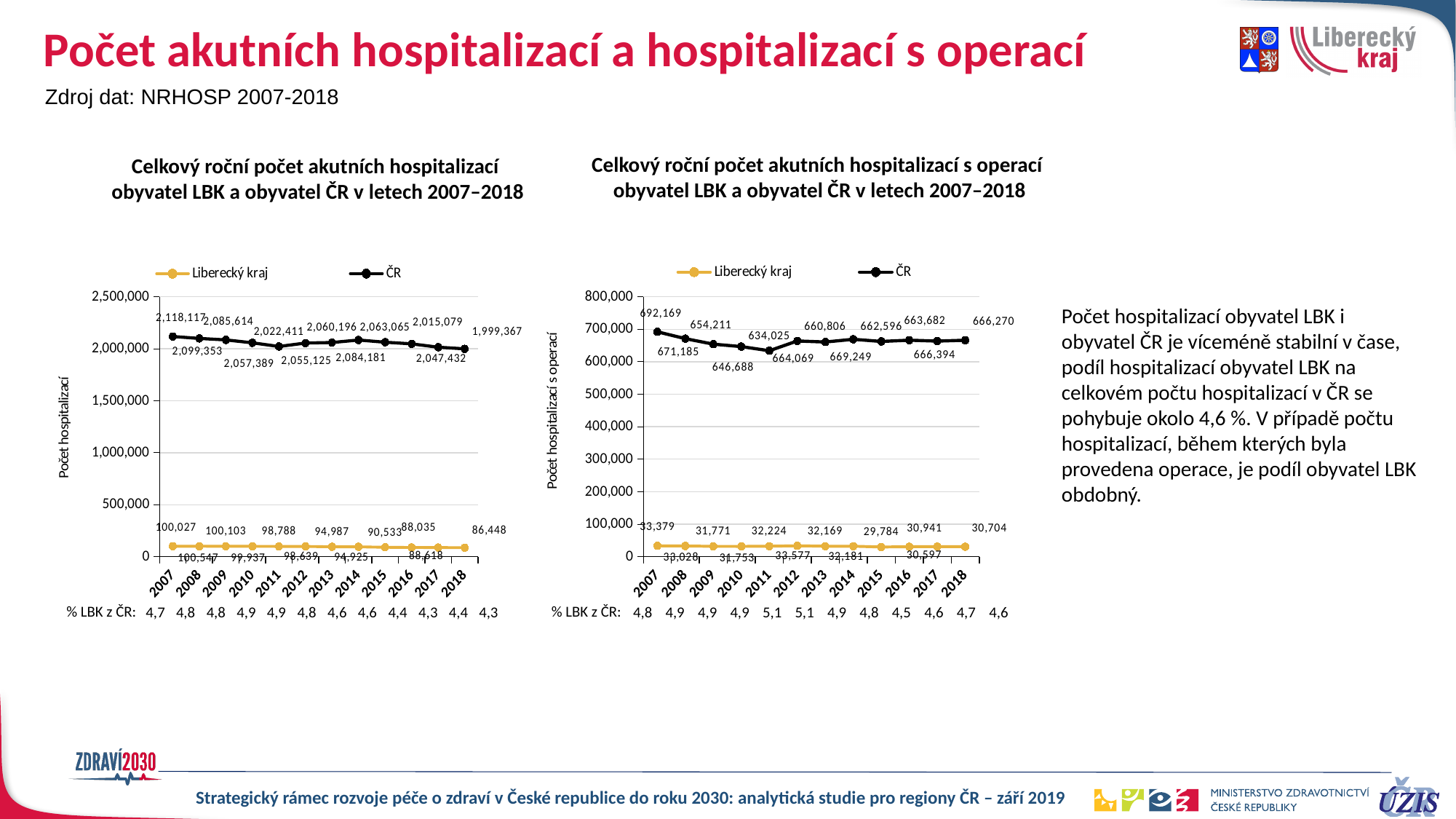
In the left chart (Celkový roční počet akutních hospitalizací), what is the value for Liberecký kraj in 2018? 86,448 In the left chart (Celkový roční počet akutních hospitalizací), what is the value for ČR in 2007? 2,118,117 In the left chart (Celkový roční počet akutních hospitalizací), in which year is the ČR value highest? 2007 In the left chart (Celkový roční počet akutních hospitalizací), is the Liberecký kraj value in 2007 greater or less than 500,000? less In the left chart (Celkový roční počet akutních hospitalizací), what is the value for ČR in 2018? 1,999,367 In the right chart (hospitalizací s operací), what is the value for ČR in 2007? 692,169 In the right chart (hospitalizací s operací), what is the difference between the ČR values in 2007 and 2018? 25,899 How many series does the legend of the right chart (hospitalizací s operací) list? 2 What type of chart is the left chart (Celkový roční počet akutních hospitalizací)? line chart In the right chart (hospitalizací s operací), what is the value for Liberecký kraj in 2015? 29,784 In the right chart (hospitalizací s operací), in which year is the ČR value lowest? 2011 In the left chart (Celkový roční počet akutních hospitalizací), does the Liberecký kraj series generally rise or fall from 2007 to 2018? fall